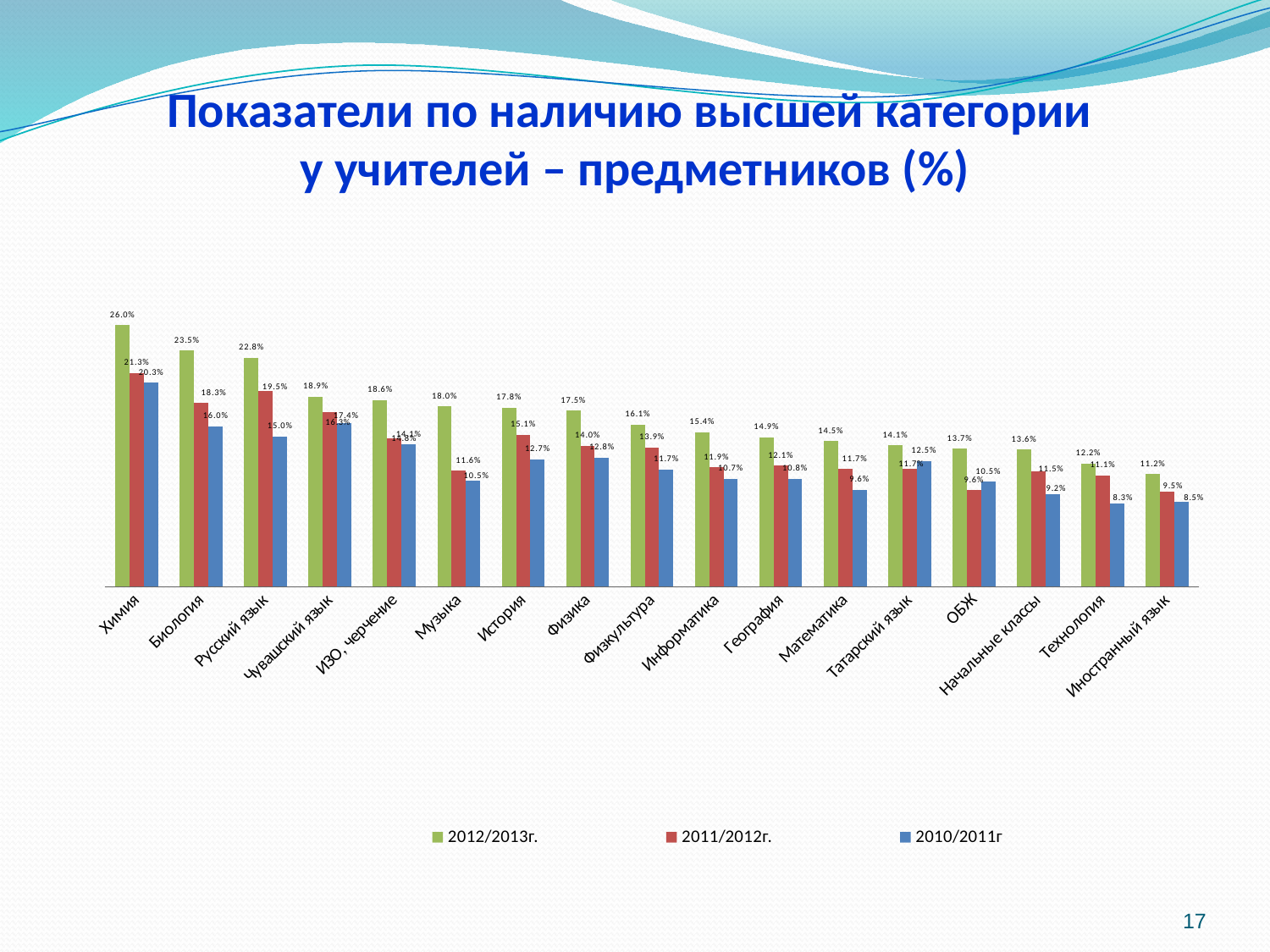
Which is larger for Татарский язык: the 2011/2012г. value or the 2010/2011г value? 2010/2011г Which subject has the lowest value in the 2012/2013г. series? Иностранный язык What is the value for Музыка in the 2010/2011г series? 10.5% Which subject has the highest value in the 2012/2013г. series? Химия How many subjects are shown on the x axis? 17 Do the 2012/2013г. values rise or fall from left to right along the x axis? Fall Which series is shown in green? 2012/2013г. What is the difference between the 2012/2013г. and 2010/2011г values for Химия? 5.7 percentage points What kind of chart is shown on the slide? Bar chart How many series does the legend list? 3 What is the value for Химия in the 2012/2013г. series? 26.0% What is the value for Биология in the 2011/2012г. series? 18.3%